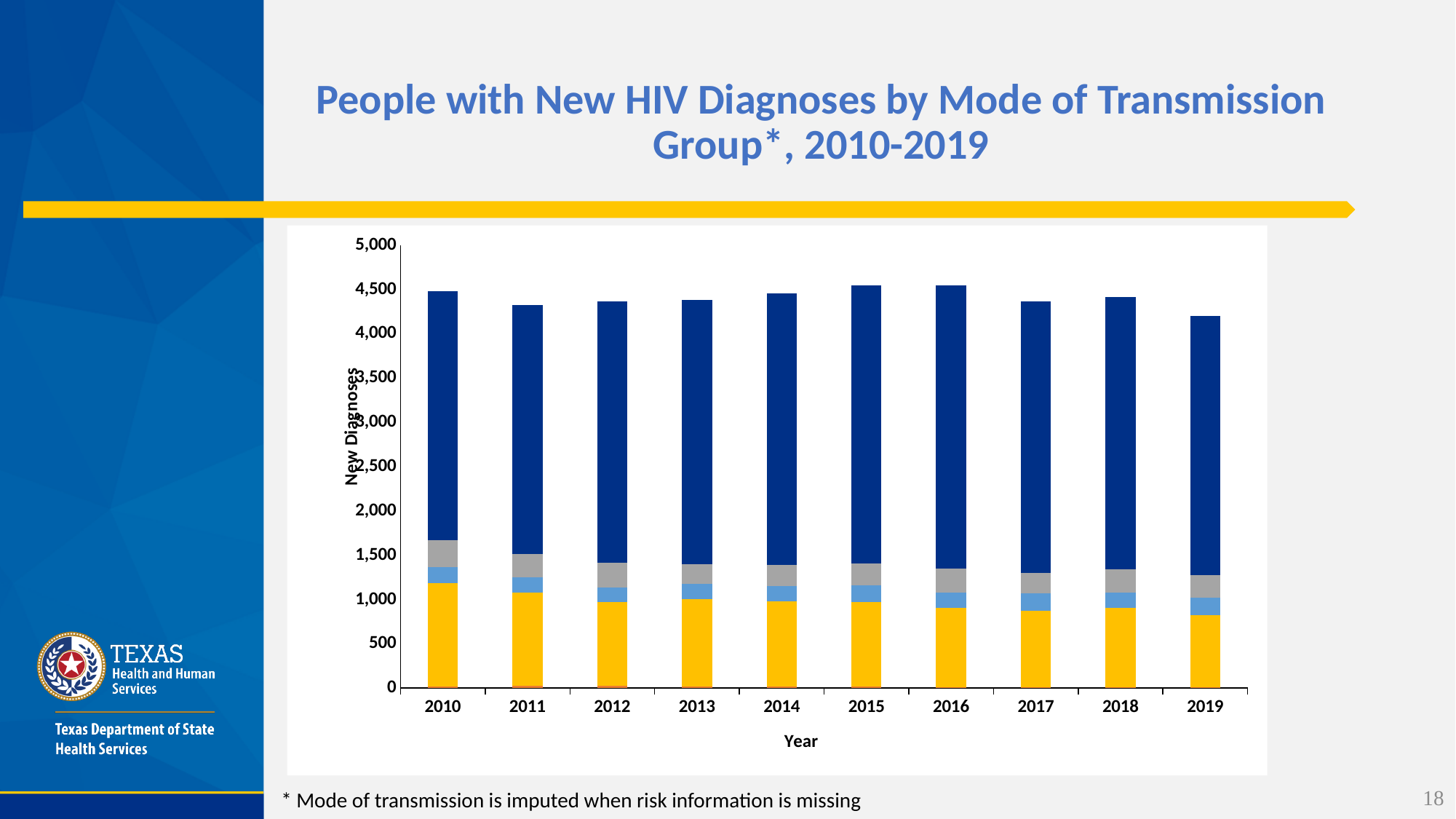
Is the total bar for 2019 greater or less than 4,500? less Is the total bar for 2010 greater or less than 4,000? greater Which year has a taller total bar, 2011 or 2015? 2015 What is the label on the y axis of the chart? New Diagnoses Is the total bar for 2011 greater or less than 4,500? less Which year has a taller total bar, 2010 or 2019? 2010 How many years are shown on the x axis of the chart? 10 Which year has the lowest total number of new HIV diagnoses? 2019 What kind of chart is shown on the slide? Stacked bar chart